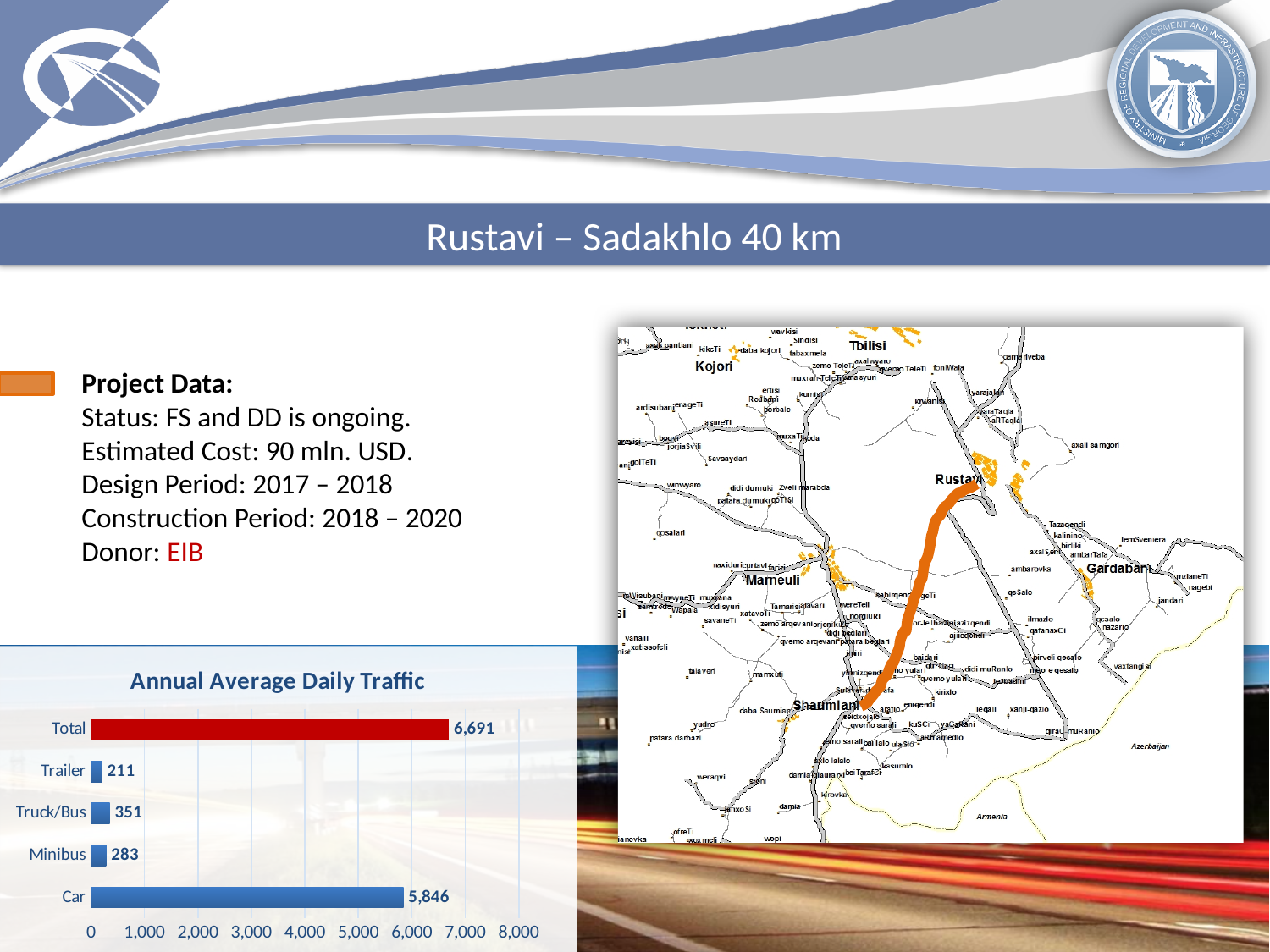
Excluding the Total bar, which vehicle category has the highest value in the Annual Average Daily Traffic chart? Car Which is larger in the Annual Average Daily Traffic chart, Truck/Bus or Trailer? Truck/Bus Is the value for Car in the Annual Average Daily Traffic chart greater or less than 5,000? greater What is the value for Minibus in the Annual Average Daily Traffic chart? 283 What is the value shown for Total in the Annual Average Daily Traffic chart? 6,691 What is the difference between the Truck/Bus and Minibus values in the Annual Average Daily Traffic chart? 68 What is the value for Car in the Annual Average Daily Traffic chart? 5,846 How many categories are shown in the Annual Average Daily Traffic chart? 5 What type of chart is the Annual Average Daily Traffic chart? Bar chart What is the value for Truck/Bus in the Annual Average Daily Traffic chart? 351 What is the value for Trailer in the Annual Average Daily Traffic chart? 211 Which category has the lowest value in the Annual Average Daily Traffic chart? Trailer